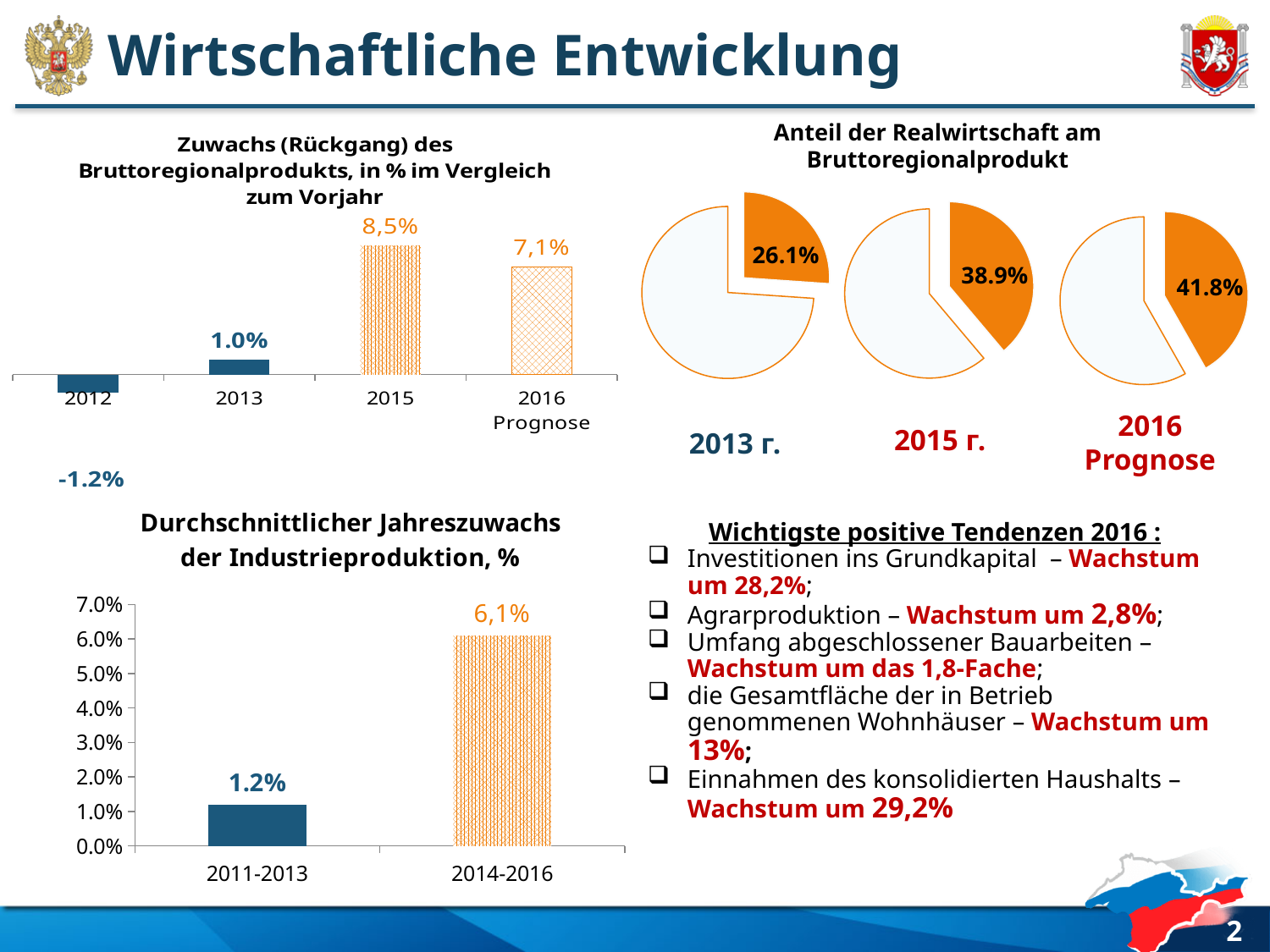
In the chart 'Zuwachs (Rückgang) des Bruttoregionalprodukts', is the value for 2015 or for 2016 Prognose larger? 2015 What kind of chart is 'Durchschnittlicher Jahreszuwachs der Industrieproduktion, %'? bar chart In the chart 'Zuwachs (Rückgang) des Bruttoregionalprodukts', which year has the highest value? 2015 In the chart 'Durchschnittlicher Jahreszuwachs der Industrieproduktion, %', what is the value for 2014-2016? 6,1% In the pie charts 'Anteil der Realwirtschaft am Bruttoregionalprodukt', how many pie charts are shown? 3 In the chart 'Zuwachs (Rückgang) des Bruttoregionalprodukts', how many categories are shown on the x axis? 4 In the chart 'Zuwachs (Rückgang) des Bruttoregionalprodukts', what is the value for 2015? 8,5% In the chart 'Durchschnittlicher Jahreszuwachs der Industrieproduktion, %', is the value for 2011-2013 greater or less than 2.0%? less In the chart 'Zuwachs (Rückgang) des Bruttoregionalprodukts', which year has the lowest value? 2012 In the chart 'Zuwachs (Rückgang) des Bruttoregionalprodukts', what is the value for 2012? -1.2% In the pie charts 'Anteil der Realwirtschaft am Bruttoregionalprodukt', what share is shown for 2015? 38.9% In the pie charts 'Anteil der Realwirtschaft am Bruttoregionalprodukt', what share is shown for 2016 Prognose? 41.8%